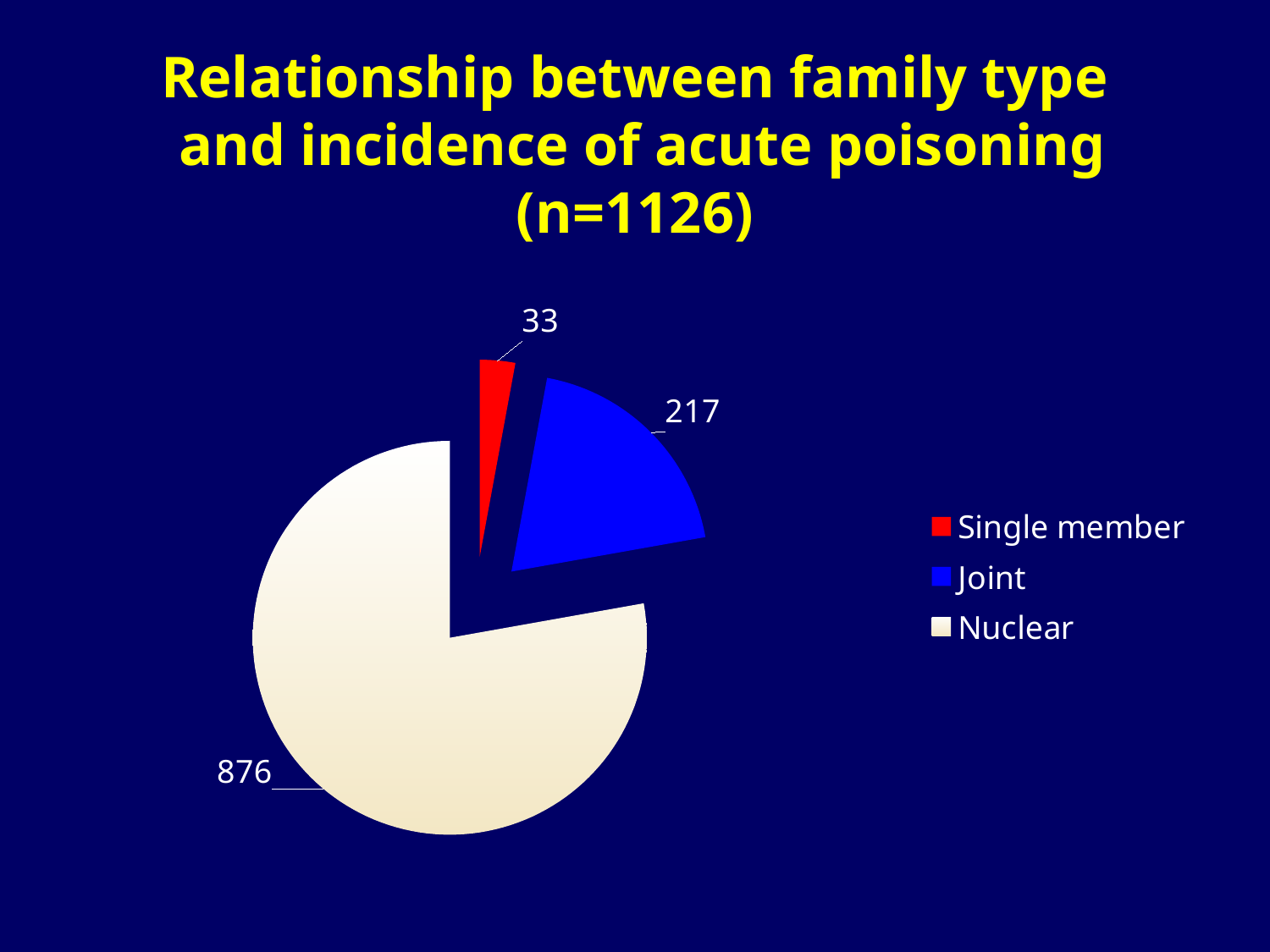
Which is larger, the value for Joint or the value for Single member? Joint Which family type has the largest slice of the pie chart? Nuclear What is the difference between the Nuclear and Joint values? 659 Which colour represents Joint families in the legend? Blue What is the value for Nuclear families in the pie chart? 876 What kind of chart is shown on the slide? Pie chart What is the value for Joint families in the pie chart? 217 What is the difference between the Joint and Single member values? 184 Which family type has the smallest slice of the pie chart? Single member What is the total of all three slices in the pie chart? 1126 How many slices does the pie chart have? 3 What is the value for Single member families in the pie chart? 33